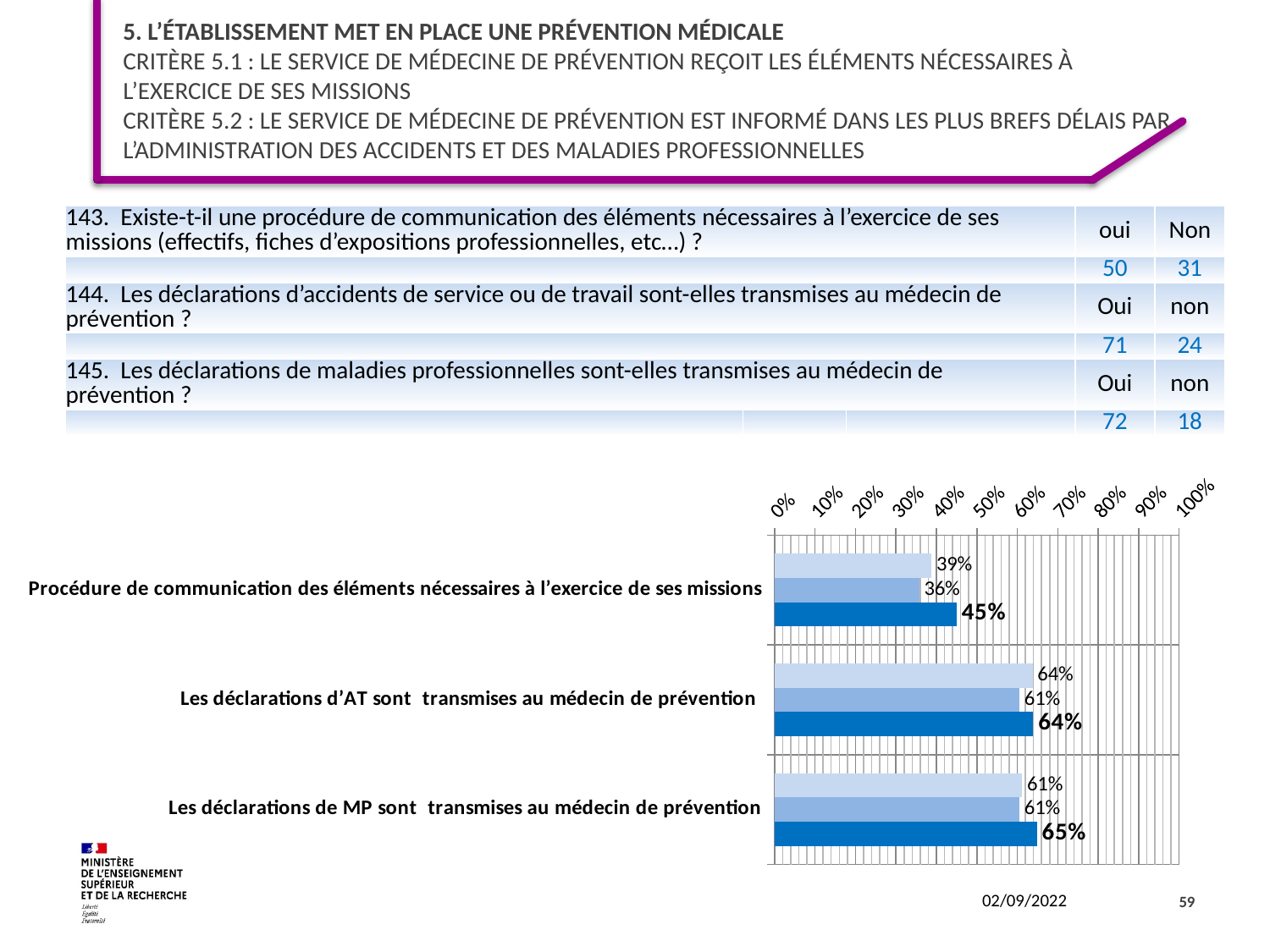
Which category has the lowest value for the dark blue (bottom) bar? Procédure de communication des éléments nécessaires à l'exercice de ses missions Which is larger: the light blue (top) bar for 'Les déclarations d'AT sont transmises au médecin de prévention' or the light blue (top) bar for 'Procédure de communication des éléments nécessaires à l'exercice de ses missions'? Les déclarations d'AT sont transmises au médecin de prévention What kind of chart is shown on the slide? bar chart What is the value of the dark blue (bottom) bar for 'Les déclarations de MP sont transmises au médecin de prévention'? 65% What is the value of the dark blue (bottom) bar for 'Procédure de communication des éléments nécessaires à l'exercice de ses missions'? 45% What is the difference between the dark blue (bottom) bar values for 'Les déclarations de MP sont transmises au médecin de prévention' and 'Procédure de communication des éléments nécessaires à l'exercice de ses missions'? 20% What is the value of the light blue (top) bar for 'Les déclarations d'AT sont transmises au médecin de prévention'? 64% Is the value of the dark blue (bottom) bar for 'Les déclarations d'AT sont transmises au médecin de prévention' greater or less than 50%? greater Which category has the highest value for the dark blue (bottom) bar? Les déclarations de MP sont transmises au médecin de prévention What is the value of the middle bar for 'Procédure de communication des éléments nécessaires à l'exercice de ses missions'? 36% How many bars are shown for each category on the chart? 3 How many categories are shown on the chart? 3